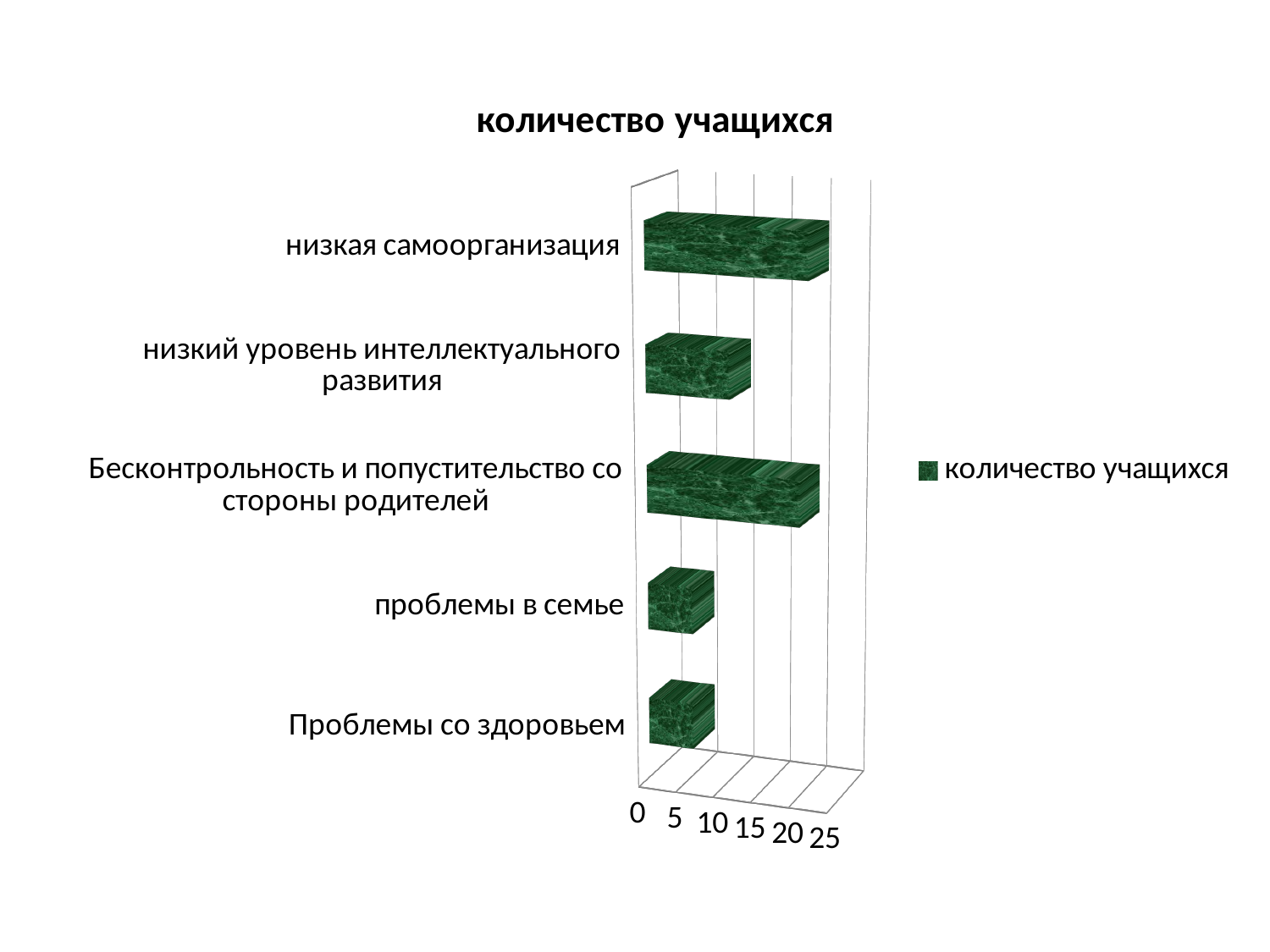
What kind of chart is shown on the slide? bar chart Is the value for проблемы в семье greater or less than 15? less How many categories are plotted in the chart? 5 What is the name of the series shown in the legend? количество учащихся What is the title of the chart? количество учащихся Is the value for низкий уровень интеллектуального развития greater or less than 5? greater Is the value for низкая самоорганизация greater or less than 15? greater Which is larger: the value for Бесконтрольность и попустительство со стороны родителей or the value for низкий уровень интеллектуального развития? Бесконтрольность и попустительство со стороны родителей How many series does the legend list? 1 Which is larger: the value for низкая самоорганизация or the value for проблемы в семье? низкая самоорганизация